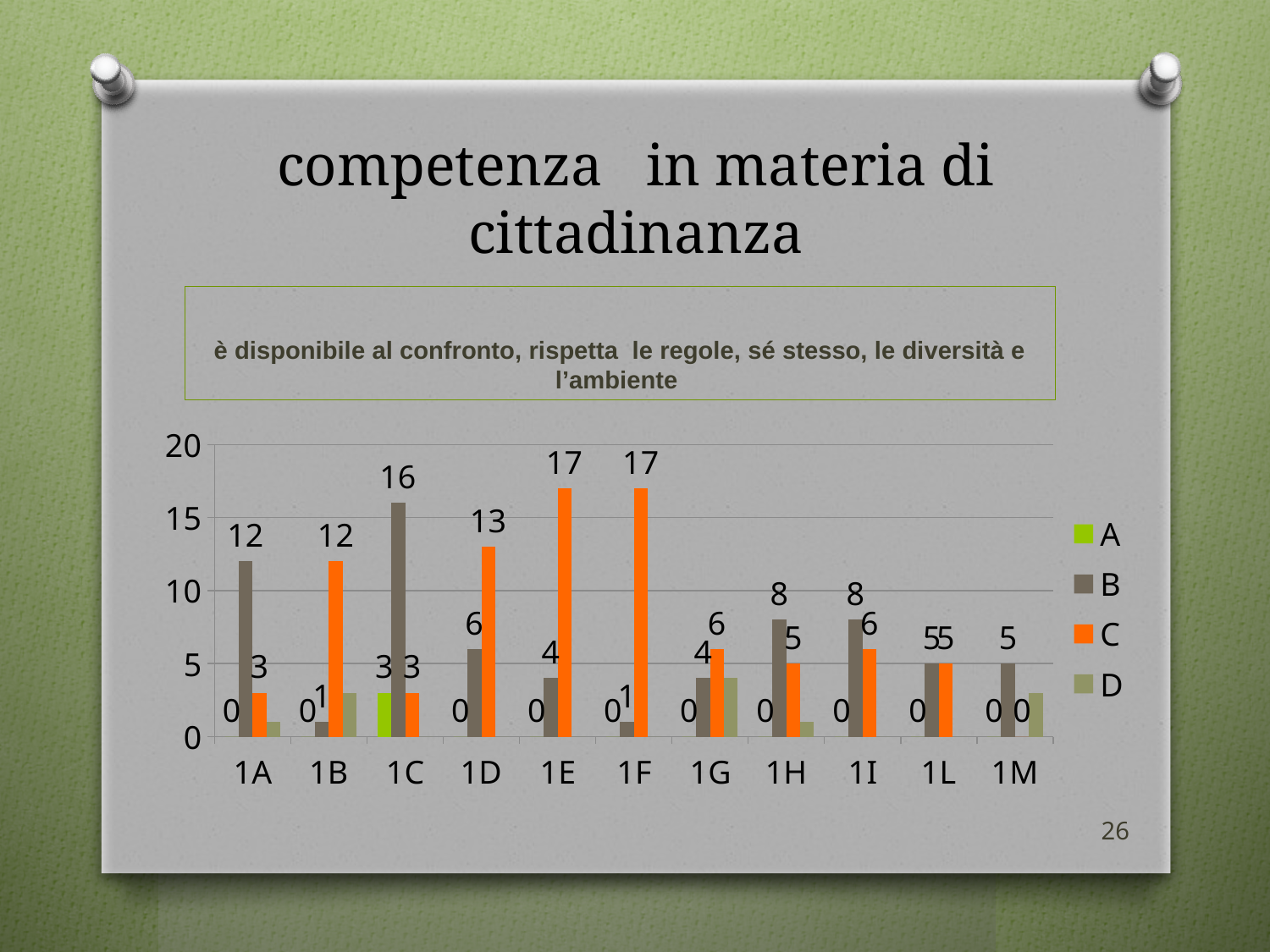
What is the difference between the series B values for 1C and 1A? 4 How many series does the legend list? 4 What is the value of series B for category 1C? 16 Is the value of series D for category 1B greater or less than 5? less For category 1D, which is larger: series B or series C? C Which category has the highest value for series B? 1C What type of chart is shown on the slide? bar chart What are the entries listed in the chart legend? A, B, C, D What is the value of series C for category 1E? 17 What is the value of series C for category 1D? 13 How many categories are shown on the x axis? 11 What is the value of series B for category 1H? 8